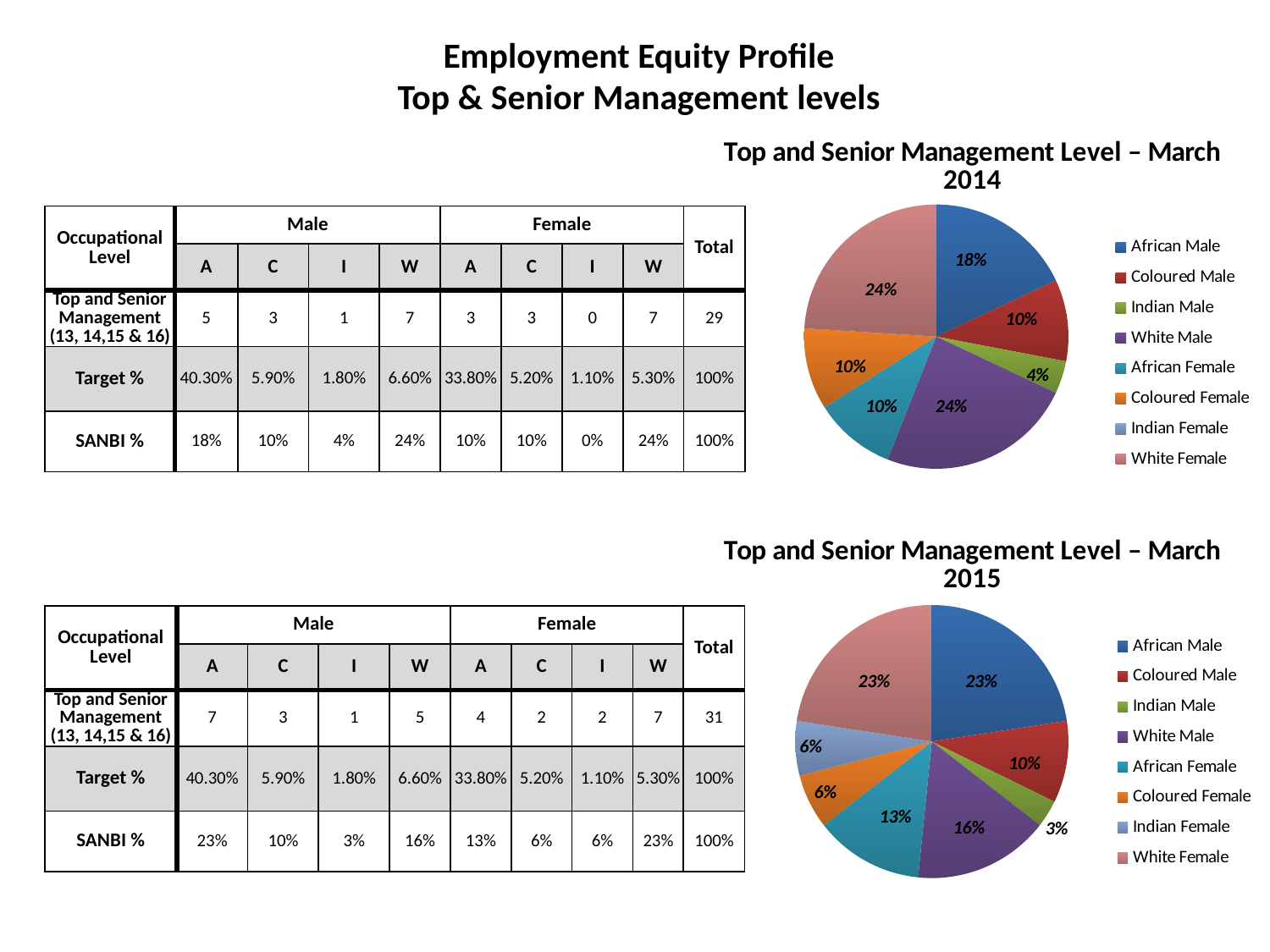
In the 'Top and Senior Management Level – March 2015' chart, what share does White Male have? 16% What kind of chart is the 'Top and Senior Management Level – March 2014' chart? pie chart How many entries does the legend of the 'Top and Senior Management Level – March 2014' chart list? 8 In the 'Top and Senior Management Level – March 2015' chart, what share does African Female have? 13% In the 'Top and Senior Management Level – March 2014' chart, what share does White Male have? 24% In the 'Top and Senior Management Level – March 2015' chart, which is larger: the African Female slice or the Coloured Female slice? African Female In the 'Top and Senior Management Level – March 2014' chart, what share does Indian Male have? 4% In the 'Top and Senior Management Level – March 2015' chart, what is the difference between the African Male share and the White Male share? 7% In the 'Top and Senior Management Level – March 2015' chart, what colour is the White Female slice? pink In the 'Top and Senior Management Level – March 2014' chart, which is larger: the Coloured Male slice or the Indian Male slice? Coloured Male In the 'Top and Senior Management Level – March 2014' chart, what share does African Male have? 18% In the 'Top and Senior Management Level – March 2015' chart, which category has the smallest slice? Indian Male